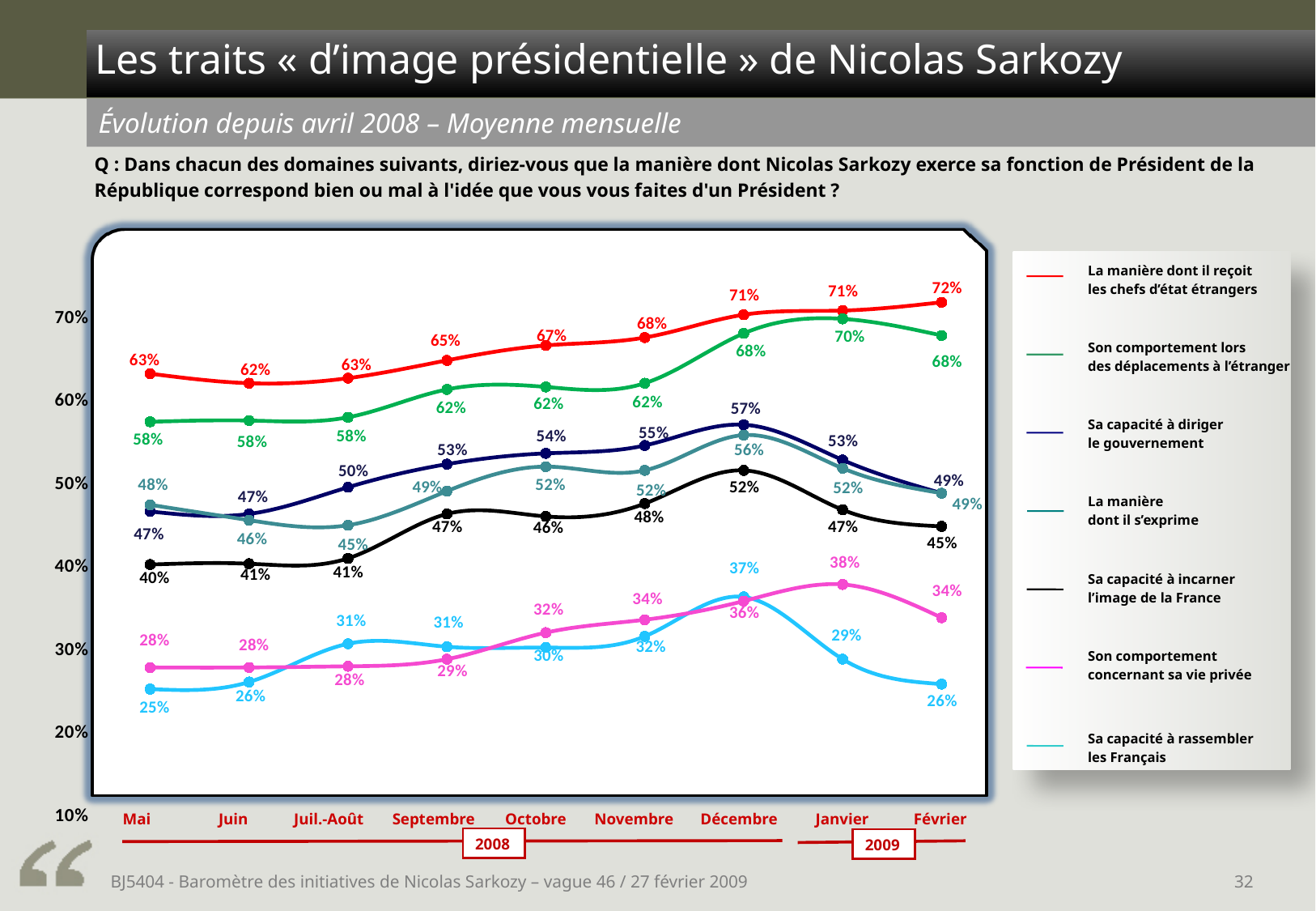
Does 'La manière dont il reçoit les chefs d'état étrangers' rise or fall from Mai to Février? rise What is the difference between 'La manière dont il reçoit les chefs d'état étrangers' and 'Son comportement lors des déplacements à l'étranger' in Mai? 5% In which month is 'Sa capacité à rassembler les Français' lowest? Mai In which month is 'Sa capacité à diriger le gouvernement' highest? Décembre How many months are shown along the x axis? 9 What is the value for 'Sa capacité à rassembler les Français' in Décembre? 37% What is the value for 'Son comportement concernant sa vie privée' in Janvier? 38% How many series does the legend list? 7 What is the value for 'La manière dont il reçoit les chefs d'état étrangers' in Février? 72% What type of chart is shown on the slide? line chart Which colour is used for the line 'Sa capacité à incarner l'image de la France'? black Which is larger in Janvier: 'Sa capacité à incarner l'image de la France' or 'Son comportement concernant sa vie privée'? Sa capacité à incarner l'image de la France